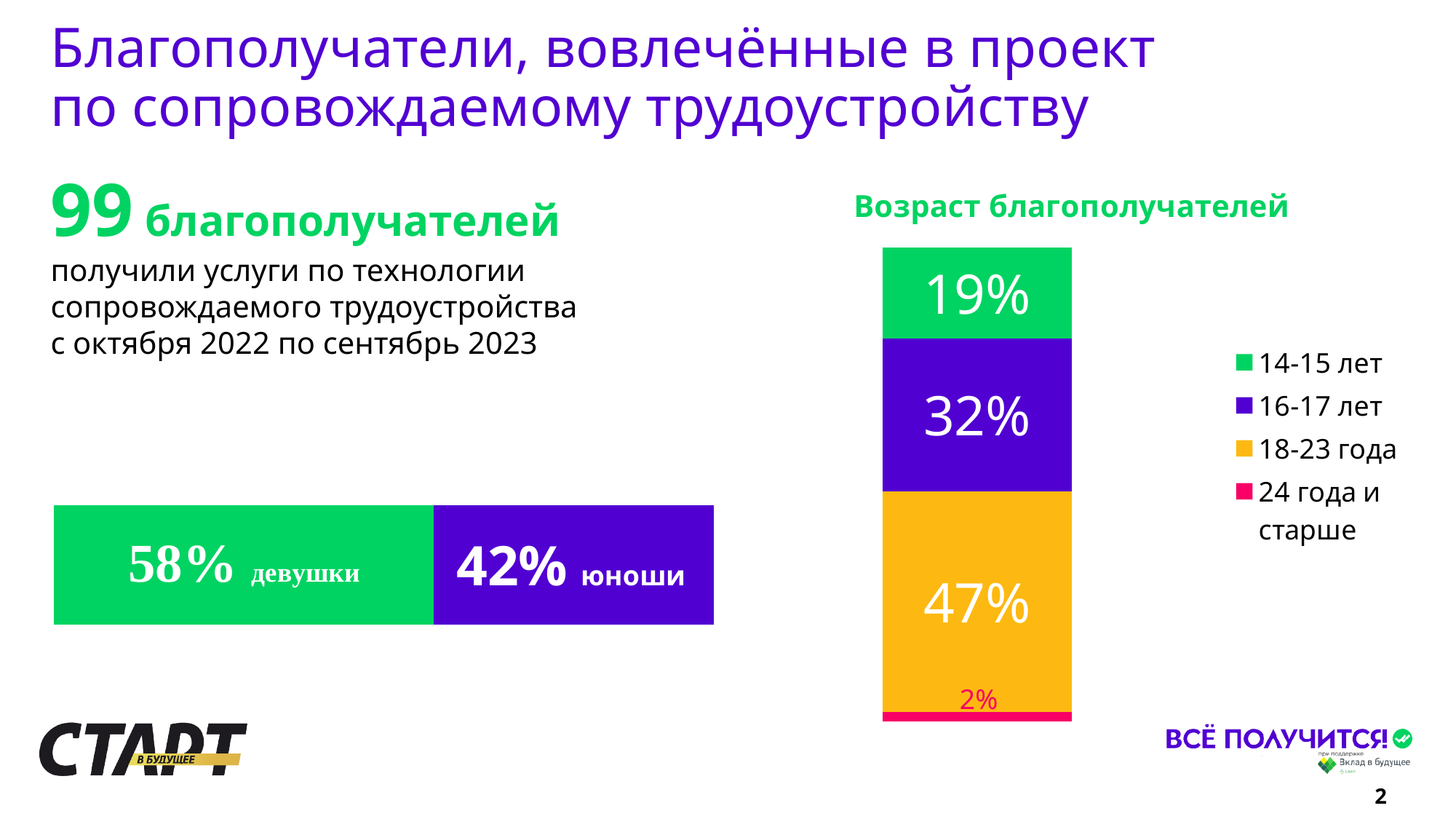
In the chart titled "Возраст благополучателей", what is the difference between the shares for 18-23 года and 16-17 лет? 15% In the chart titled "Возраст благополучателей", which is larger: the share for 16-17 лет or the share for 14-15 лет? 16-17 лет How many age groups does the legend of the chart titled "Возраст благополучателей" list? 4 What kind of chart is the chart titled "Возраст благополучателей"? Stacked bar chart In the chart titled "Возраст благополучателей", what share of beneficiaries are aged 24 года и старше? 2% In the gender bar on the left of the slide, what percentage is shown for девушки? 58% In the chart titled "Возраст благополучателей", which age group has the largest share? 18-23 года In the chart titled "Возраст благополучателей", which age group has the smallest share? 24 года и старше In the chart titled "Возраст благополучателей", what share of beneficiaries are aged 16-17 лет? 32% In the chart titled "Возраст благополучателей", what colour is the segment for 18-23 года? Orange In the chart titled "Возраст благополучателей", what share of beneficiaries are aged 14-15 лет? 19% In the chart titled "Возраст благополучателей", what share of beneficiaries are aged 18-23 года? 47%